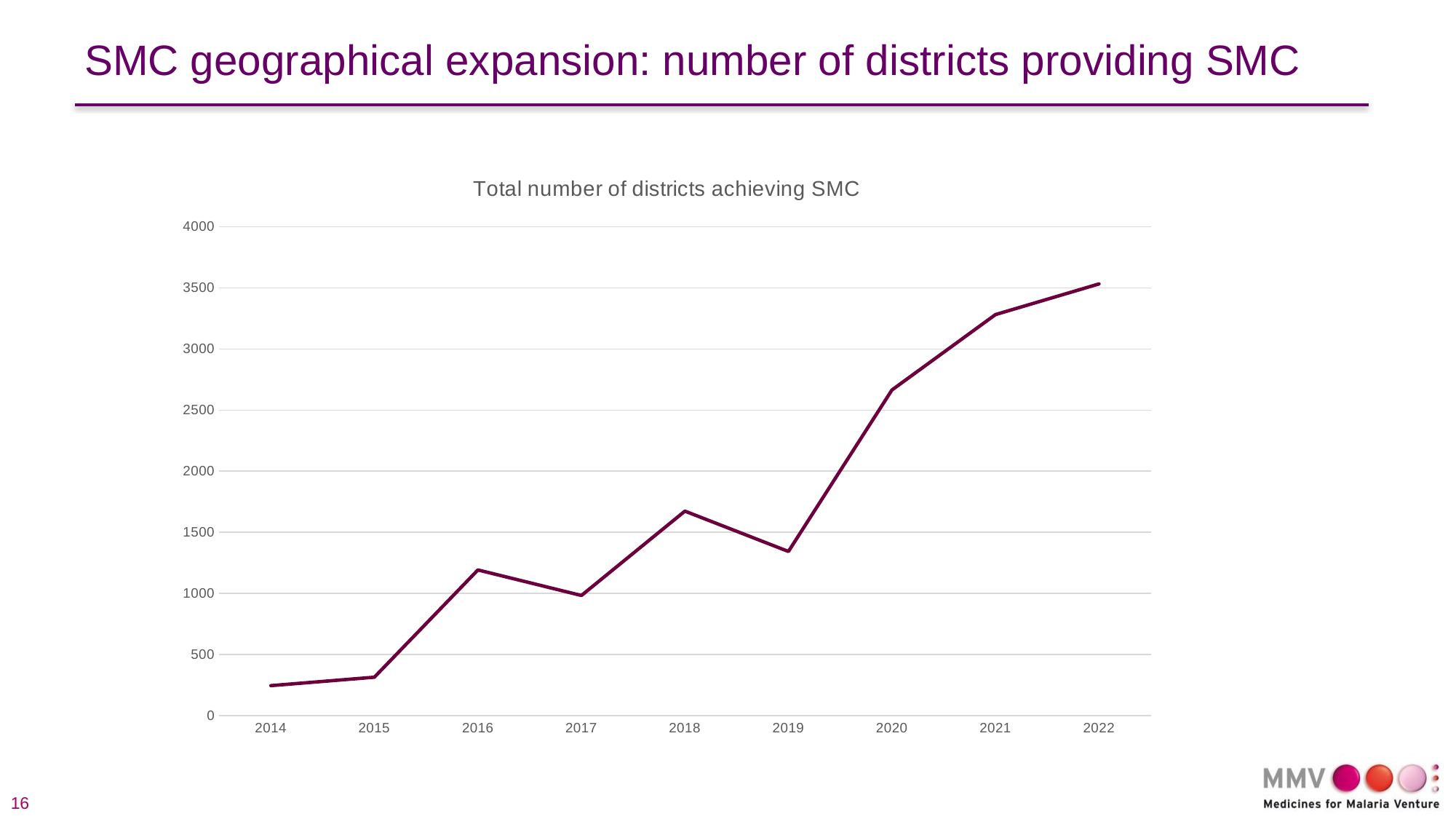
What kind of chart is shown on the slide? line chart What is the title of the chart? Total number of districts achieving SMC Which year has the larger value, 2018 or 2019? 2018 Which year has the lowest number of districts achieving SMC? 2014 Is the value for 2020 greater or less than 2500? greater How many years are plotted on the x axis? 9 Overall, do the values rise or fall from 2014 to 2022? rise Which year has the highest number of districts achieving SMC? 2022 Which year has the larger value, 2016 or 2017? 2016 Is the value for 2014 greater or less than 500? less